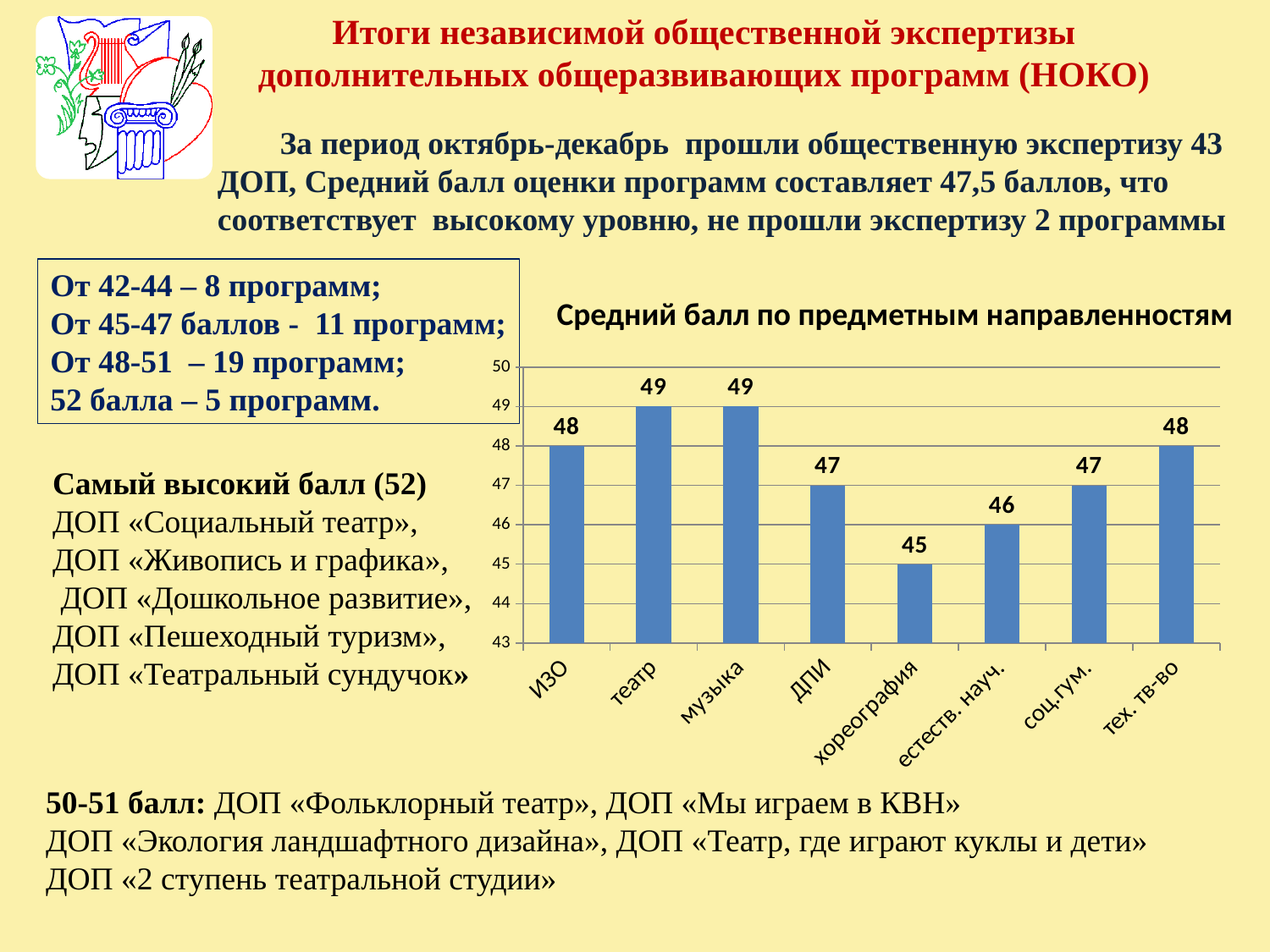
What is the difference between the scores for театр and хореография? 4 What is the average score for ИЗО? 48 What is the difference between the scores for ИЗО and ДПИ? 1 What is the average score for тех. тв-во? 48 What kind of chart is shown on the slide? bar chart What is the average score for хореография? 45 Which category has the lowest average score? хореография Which has a higher score, естеств. науч. or хореография? естеств. науч. Which has a higher score, музыка or соц.гум.? музыка What is the title of the chart? Средний балл по предметным направленностям How many categories are shown in the chart? 8 What is the average score for естеств. науч.? 46